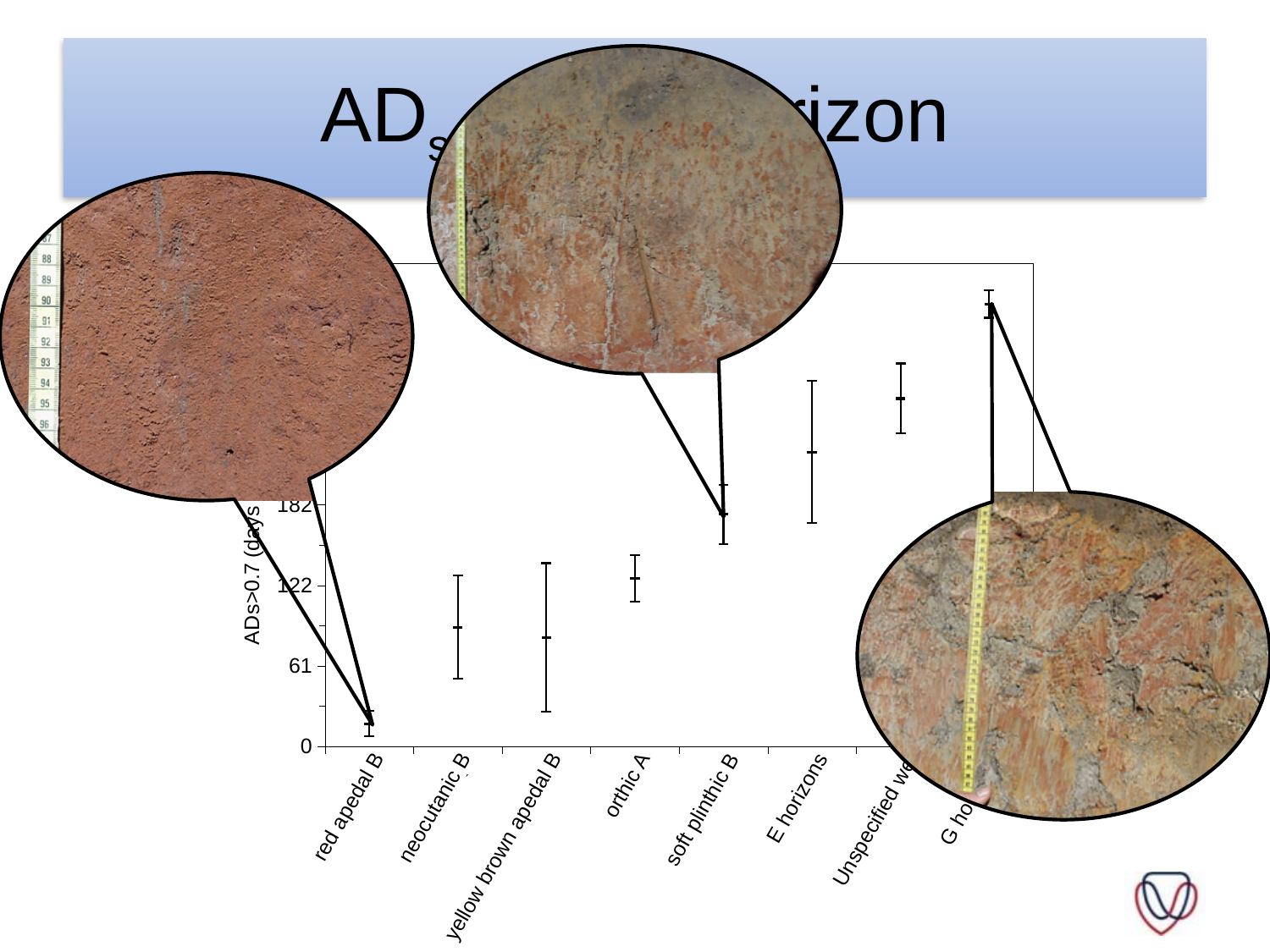
What is the label of the y axis? ADs>0.7 (days) Which is larger, the value for orthic A or the value for red apedal B? orthic A Do the values generally rise or fall from left to right along the x axis? rise Is the value for neocutanic B greater or less than 122? less Which is larger, the value for soft plinthic B or the value for yellow brown apedal B? soft plinthic B Is the value for yellow brown apedal B greater or less than 122? less Which category has the lowest value on the chart? red apedal B Is the value for red apedal B greater or less than 61? less Which is larger, the value for E horizons or the value for neocutanic B? E horizons How many categories are plotted along the x axis? 8